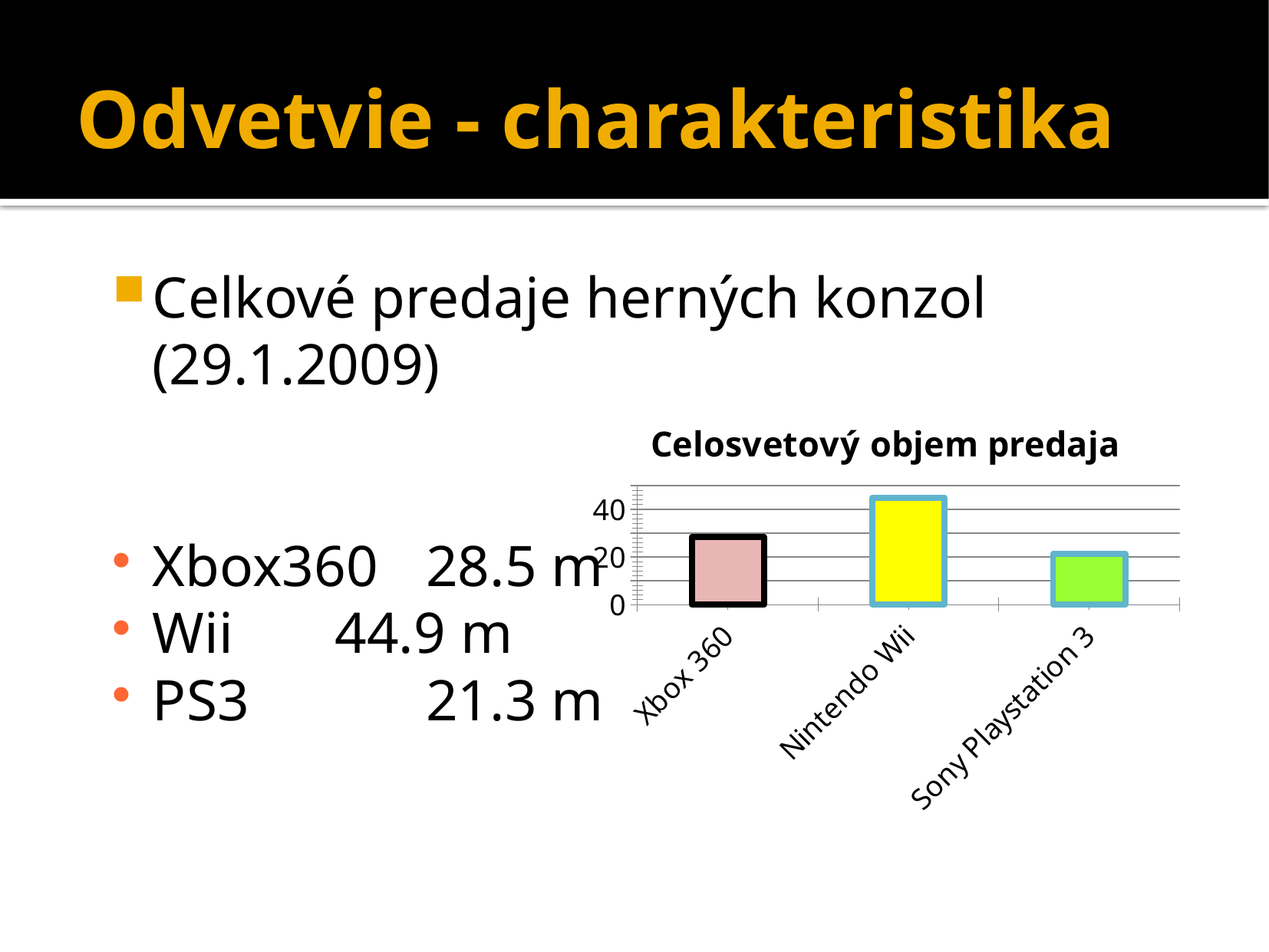
What kind of chart is shown on the slide? bar chart Is the value for Xbox 360 greater or less than 40? less What colour is the bar for Nintendo Wii? yellow Is the value for Nintendo Wii greater or less than 40? greater Which category has the highest bar in the chart? Nintendo Wii Is the value for Xbox 360 greater or less than 20? greater Which category has the lowest bar in the chart? Sony Playstation 3 What is the title of the chart? Celosvetový objem predaja Which is larger in the chart, the value for Xbox 360 or the value for Nintendo Wii? Nintendo Wii How many categories are plotted in the chart? 3 Which is larger in the chart, the value for Xbox 360 or the value for Sony Playstation 3? Xbox 360